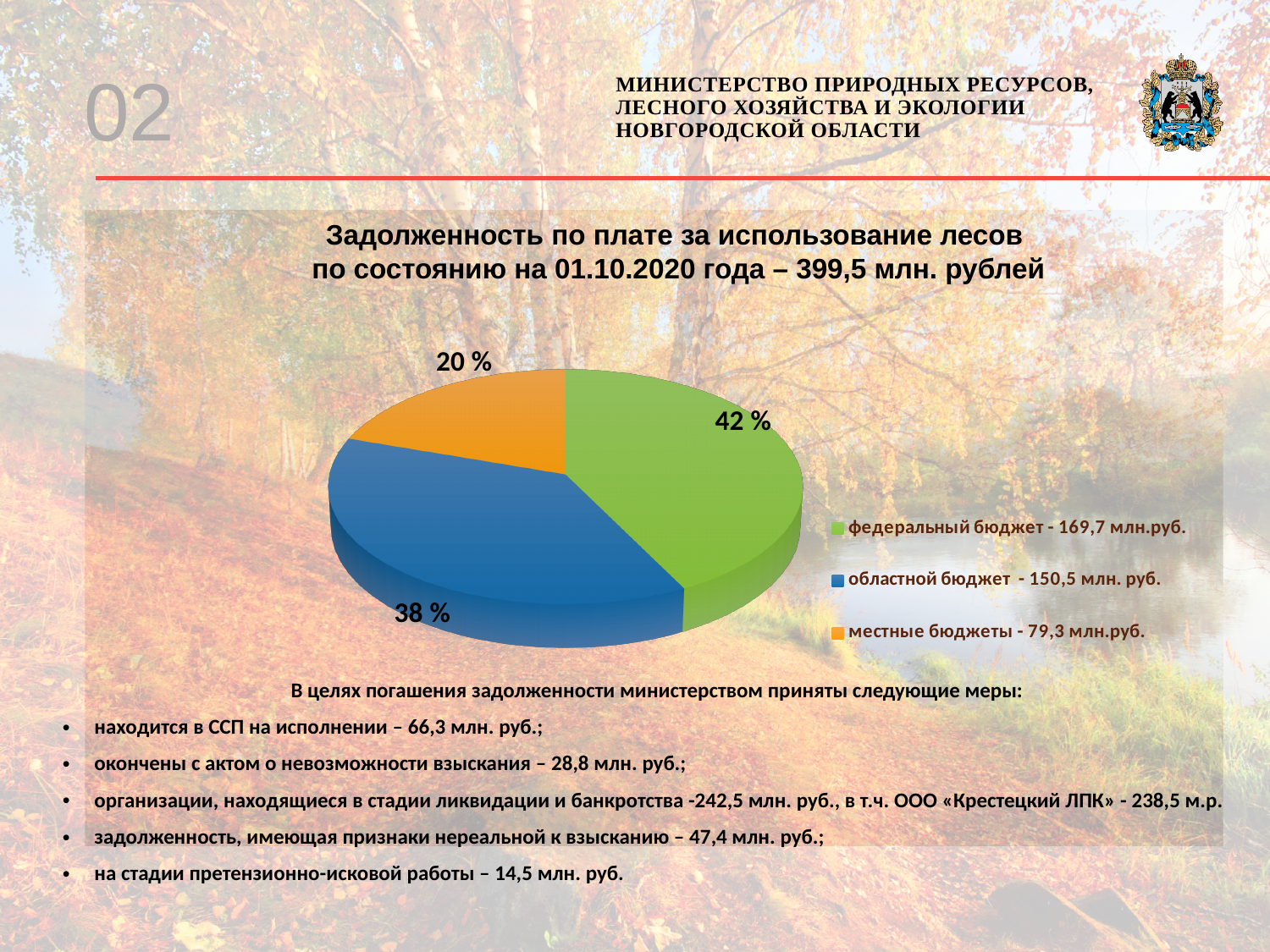
Which slice of the pie chart is the smallest? местные бюджеты Which slice of the pie chart is the largest? федеральный бюджет What amount is given in the legend for местные бюджеты? 79,3 млн.руб. How many slices does the pie chart have? 3 How many entries does the legend of the pie chart list? 3 What amount is given in the legend for областной бюджет? 150,5 млн. руб. What kind of chart is shown on the slide? Pie chart What share of the pie does the федеральный бюджет slice represent? 42 % What share of the pie does the местные бюджеты slice represent? 20 % What colour is the областной бюджет slice in the pie chart? Blue What amount is given in the legend for федеральный бюджет? 169,7 млн.руб. What share of the pie does the областной бюджет slice represent? 38 %